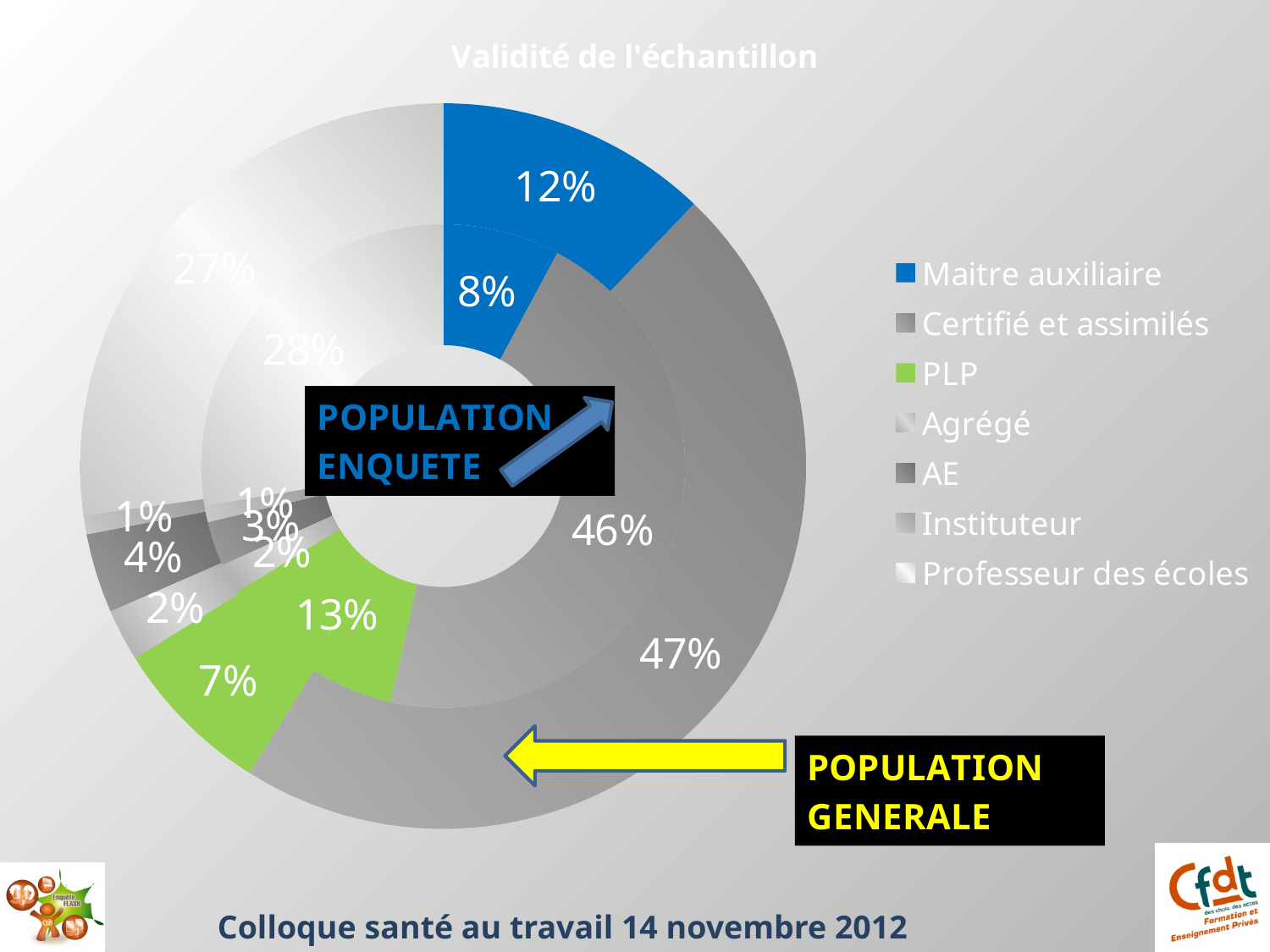
Is the share of Maitre auxiliaire larger in the POPULATION ENQUETE ring or the POPULATION GENERALE ring? POPULATION GENERALE What is the share of PLP in the inner ring (POPULATION ENQUETE)? 13% What is the title of the chart? Validité de l'échantillon What is the share of Certifié et assimilés in the inner ring (POPULATION ENQUETE)? 46% Which category has the largest share in the outer ring (POPULATION GENERALE)? Certifié et assimilés What kind of chart is shown on the slide? Doughnut chart What is the share of Maitre auxiliaire in the outer ring (POPULATION GENERALE)? 12% What is the share of Maitre auxiliaire in the inner ring (POPULATION ENQUETE)? 8% How many rings (series) does the doughnut chart have? 2 What is the share of Certifié et assimilés in the outer ring (POPULATION GENERALE)? 47% How many categories does the chart legend list? 7 By how many percentage points does the PLP share in the POPULATION ENQUETE ring (13%) exceed its share in the POPULATION GENERALE ring (7%)? 6 percentage points